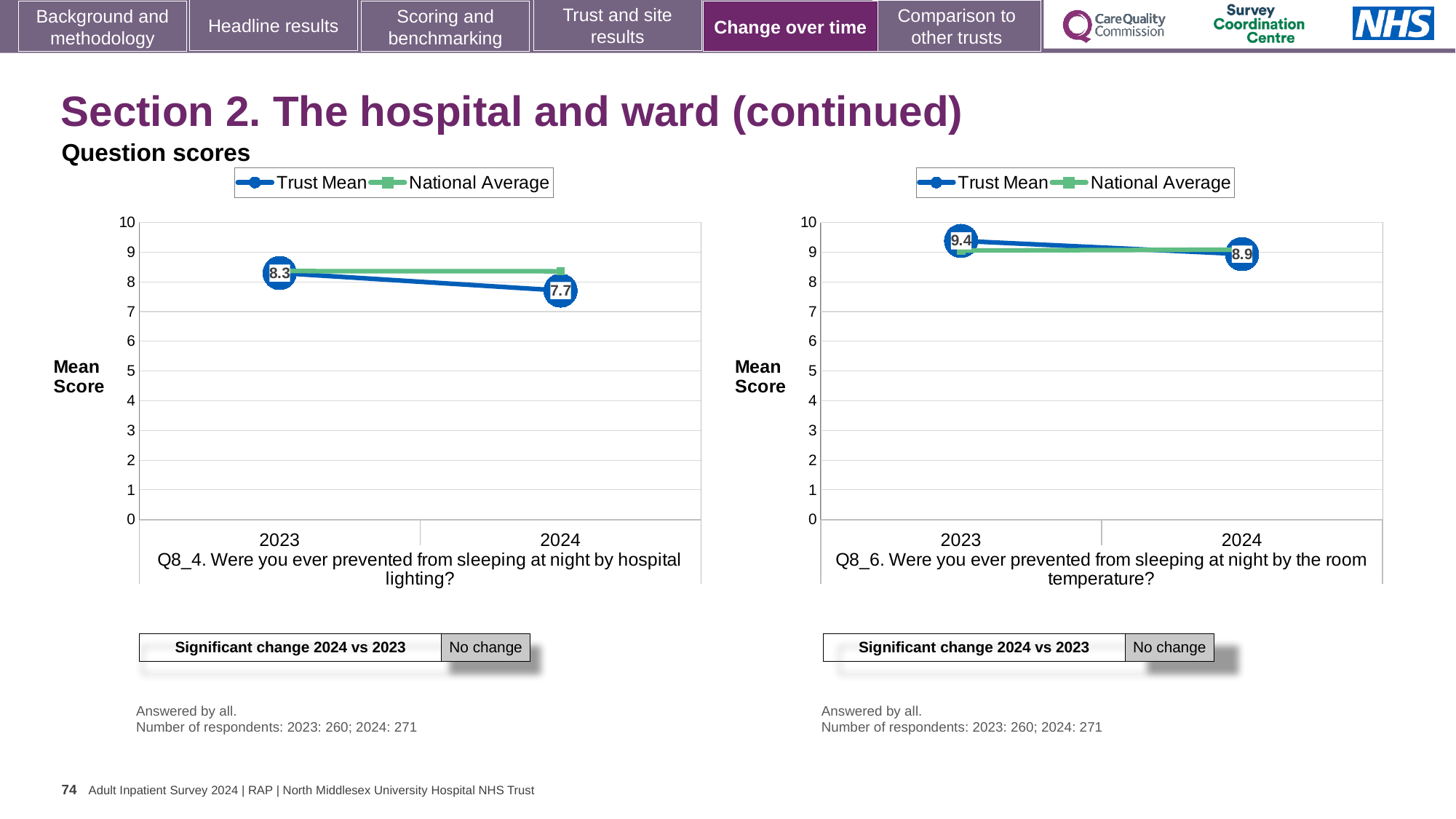
How many series does the legend of the Q8_4 chart (left) list? 2 In the Q8_6 chart (right), what is the difference between the Trust Mean in 2023 and in 2024? 0.5 In the Q8_4 chart (left), does the Trust Mean rise or fall from 2023 to 2024? fall What kind of chart is the Q8_6 chart (right)? line chart How many years are shown on the x axis of the Q8_6 chart (right)? 2 In the Q8_6 chart (right), what is the Trust Mean score for 2024? 8.9 In the Q8_6 chart (right), what is the Trust Mean score for 2023? 9.4 In the Q8_4 chart (left), by how much did the Trust Mean fall from 2023 to 2024? 0.6 In the Q8_4 chart (left), what is the Trust Mean score for 2024? 7.7 In the Q8_4 chart (left), is the National Average value for 2024 greater or less than 7? greater In the Q8_4 chart (left), what is the Trust Mean score for 2023? 8.3 In the Q8_6 chart (right), is the Trust Mean higher in 2023 or in 2024? 2023